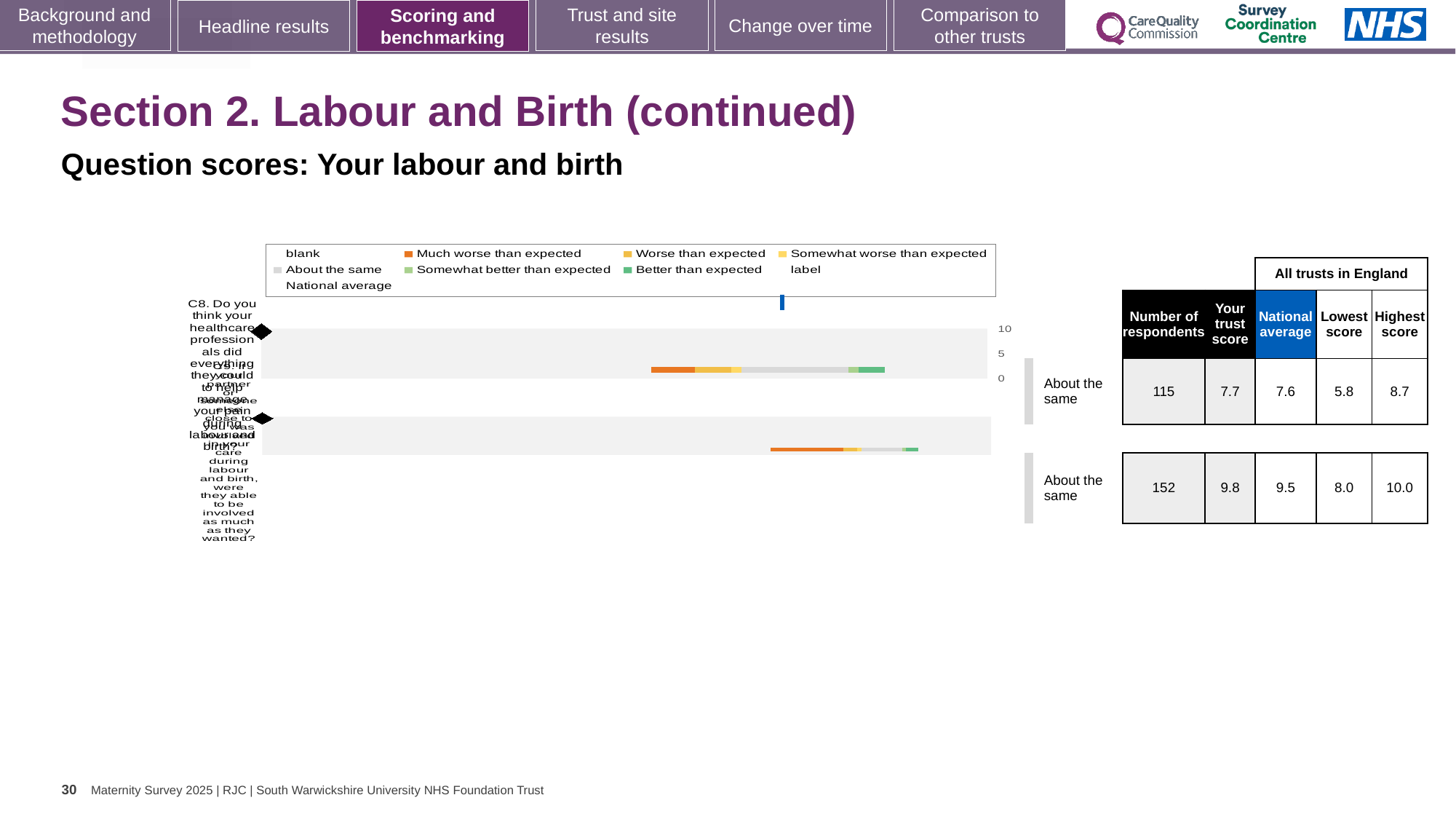
What kind of chart is shown on the slide? bar chart For the first (top) question row, which is larger: the trust score or the national average? the trust score What benchmark category label is shown beside both question rows? About the same What is the highest score across all trusts in England for the second (bottom) question row? 10.0 How many question rows are plotted in the chart? 2 What is the national average for the first (top) question row? 7.6 Which question row has the higher trust score? the second (bottom) row Is the trust score for the second (bottom) question row greater or less than 5? greater For the second (bottom) question row, how much higher is the trust score than the national average? 0.3 What is the 'Your trust score' value for the first (top) question row? 7.7 What is the difference between the highest score and the lowest score for the first (top) question row? 2.9 How many respondents are listed for the second (bottom) question row? 152